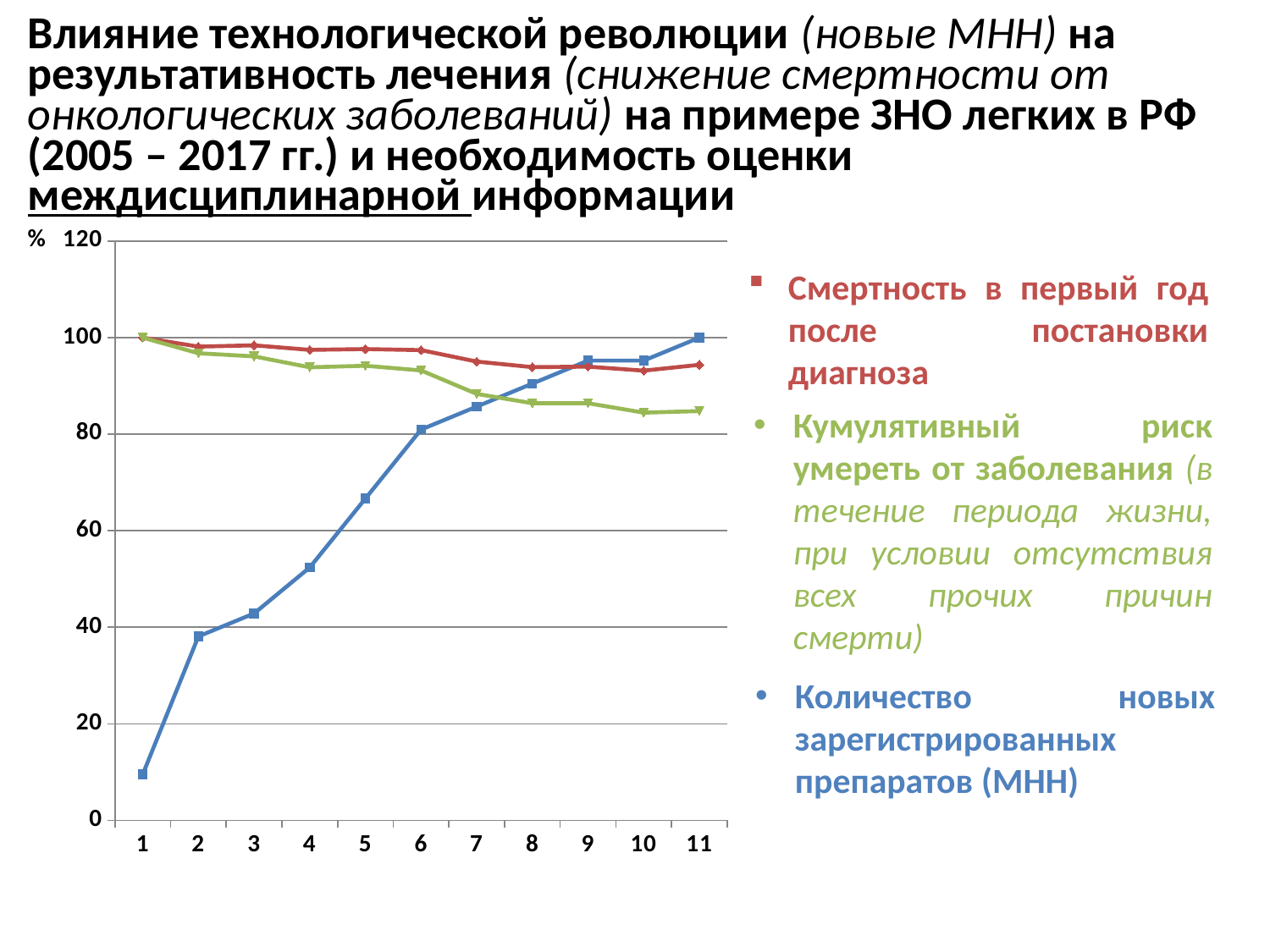
At point 1, which is larger: the red series or the blue series? the red series At which x-axis point does the blue series reach its highest value? 11 Is the value of the green series at point 11 greater or less than 80? greater Does the green series (Кумулятивный риск умереть от заболевания) rise or fall from point 1 to point 11? falls Is the value of the blue series at point 5 greater or less than 60? greater How many series does the chart's legend list? 3 Is the value of the blue series at point 4 greater or less than 40? greater What kind of chart is shown on the slide? line chart How many points are plotted along the x axis of the chart? 11 Does the blue series (Количество новых зарегистрированных препаратов (МНН)) rise or fall from point 1 to point 11? rises What unit is shown at the top of the y axis? %